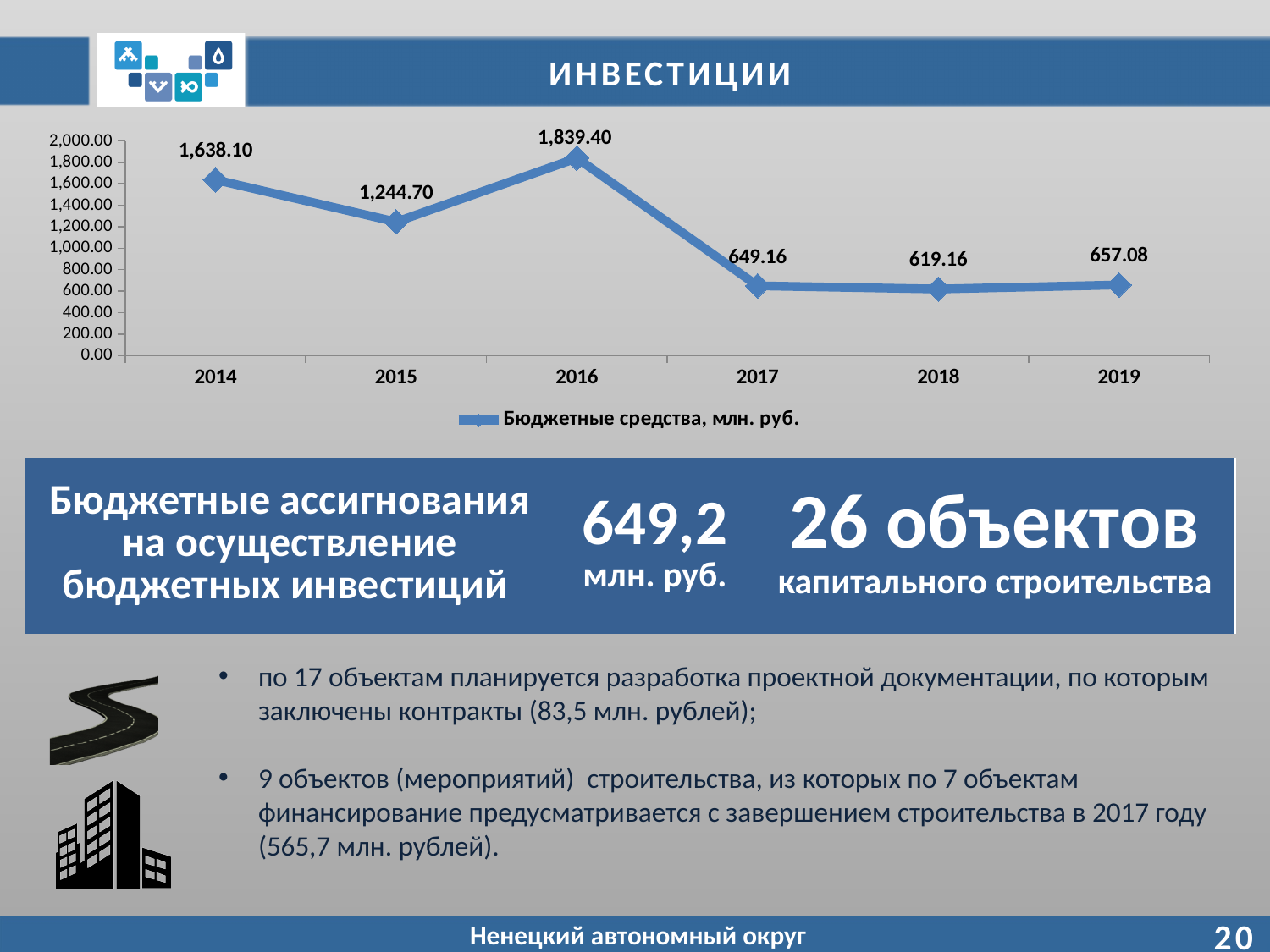
What is the value for 2018 in the line chart? 619.16 Which is larger in the line chart, the value for 2014 or the value for 2015? 2014 What is the difference between the values for 2019 and 2018 in the line chart? 37.92 Is the value for 2017 in the line chart greater or less than 1,000.00? less What is the difference between the values for 2016 and 2015 in the line chart? 594.70 What is the value for 2016 in the line chart? 1,839.40 What is the value for 2014 in the line chart? 1,638.10 Which year has the highest value in the line chart? 2016 What is the legend entry of the series in the line chart? Бюджетные средства, млн. руб. What type of chart is shown on the slide? line chart Which year has the lowest value in the line chart? 2018 How many years are plotted in the line chart? 6